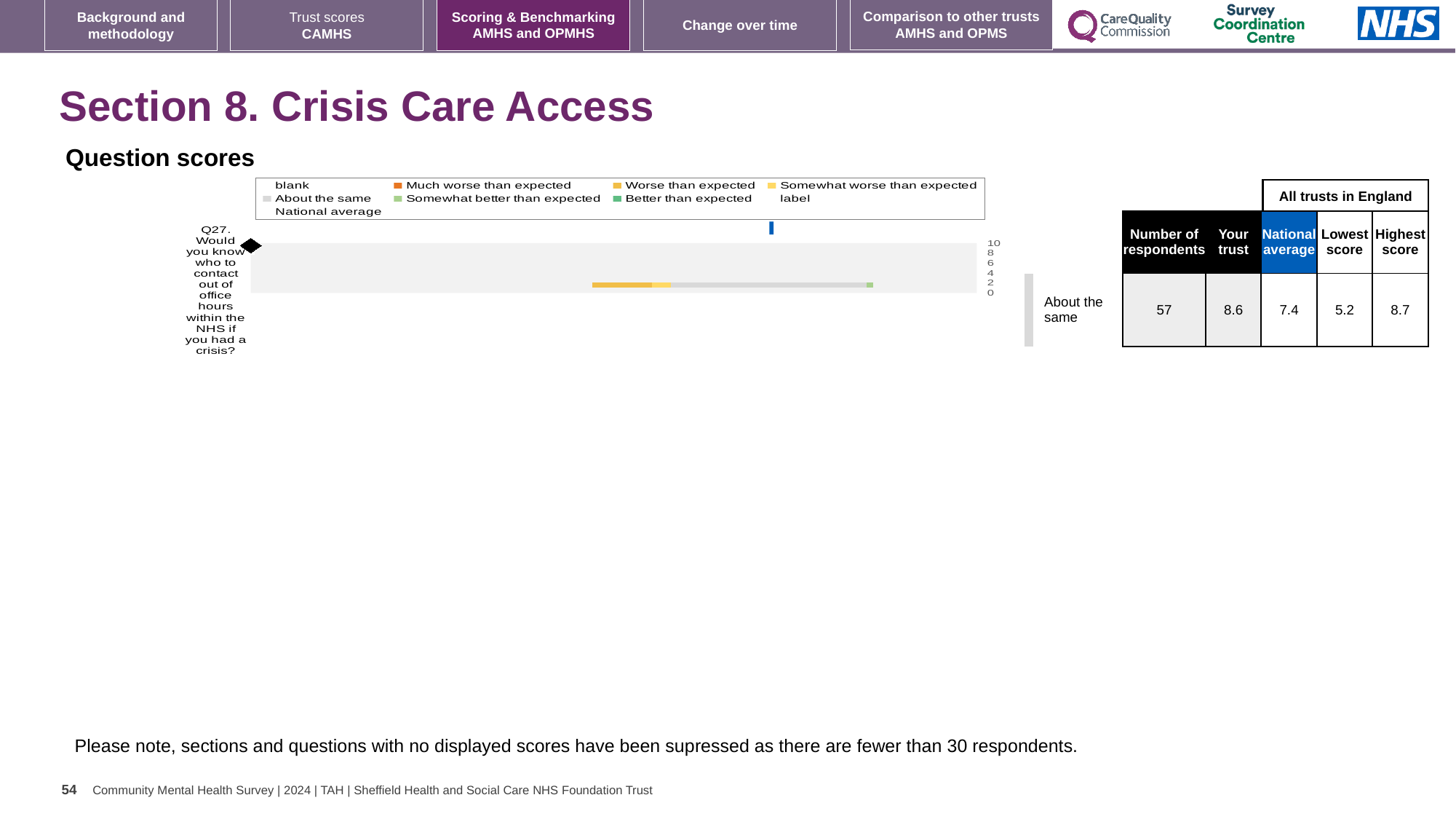
What is the lowest score among all trusts in England for Q27? 5.2 What is the highest score among all trusts in England for Q27? 8.7 What benchmark category label is shown to the right of the Q27 bar? About the same What is the national average score for Q27? 7.4 Which is larger for Q27, the 'Your trust' score or the national average? Your trust How many questions (categories) are plotted in the Question scores chart? 1 Which question is plotted in the Question scores chart? Q27. Would you know who to contact out of office hours within the NHS if you had a crisis? What type of chart is shown under 'Question scores'? bar chart What is the number of respondents for Q27? 57 What is the 'Your trust' score for Q27? 8.6 What is the highest value shown on the chart's score axis? 10 What is the difference between the 'Your trust' score and the national average for Q27? 1.2